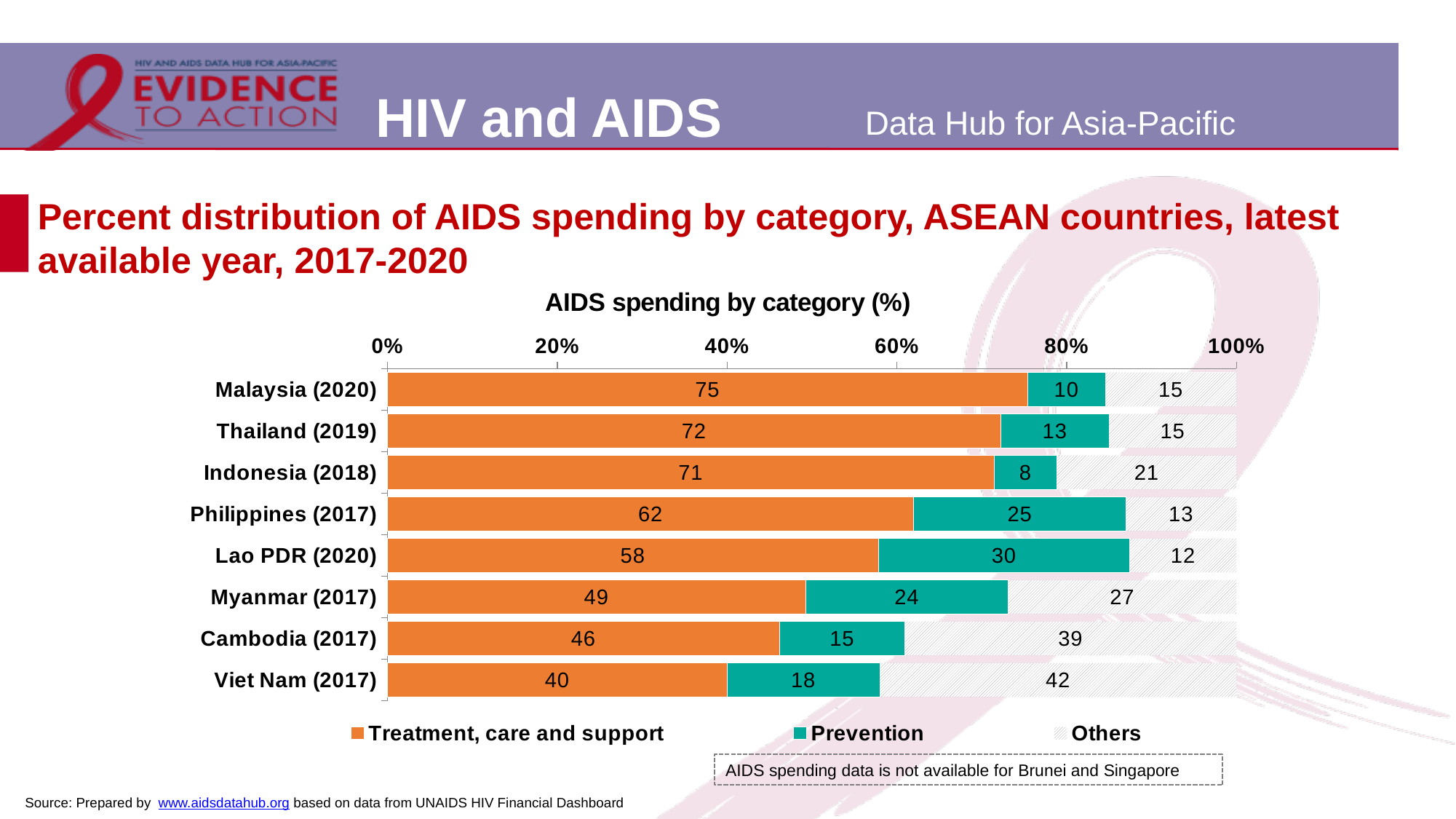
What is the Treatment, care and support value for Malaysia (2020)? 75 How many series does the legend list? 3 What kind of chart is shown on the slide? Stacked bar chart Which country has the highest Treatment, care and support share? Malaysia (2020) What is the title of the chart? AIDS spending by category (%) What is the total of the stacked bar for Indonesia (2018)? 100 What is the Others value for Viet Nam (2017)? 42 What is the difference between the Others values for Cambodia (2017) and Philippines (2017)? 26 Which is larger, the Prevention value for Myanmar (2017) or for Thailand (2019)? Myanmar (2017) Which country has the lowest Prevention share? Indonesia (2018) How many countries are shown in the chart? 8 What is the Prevention value for Lao PDR (2020)? 30